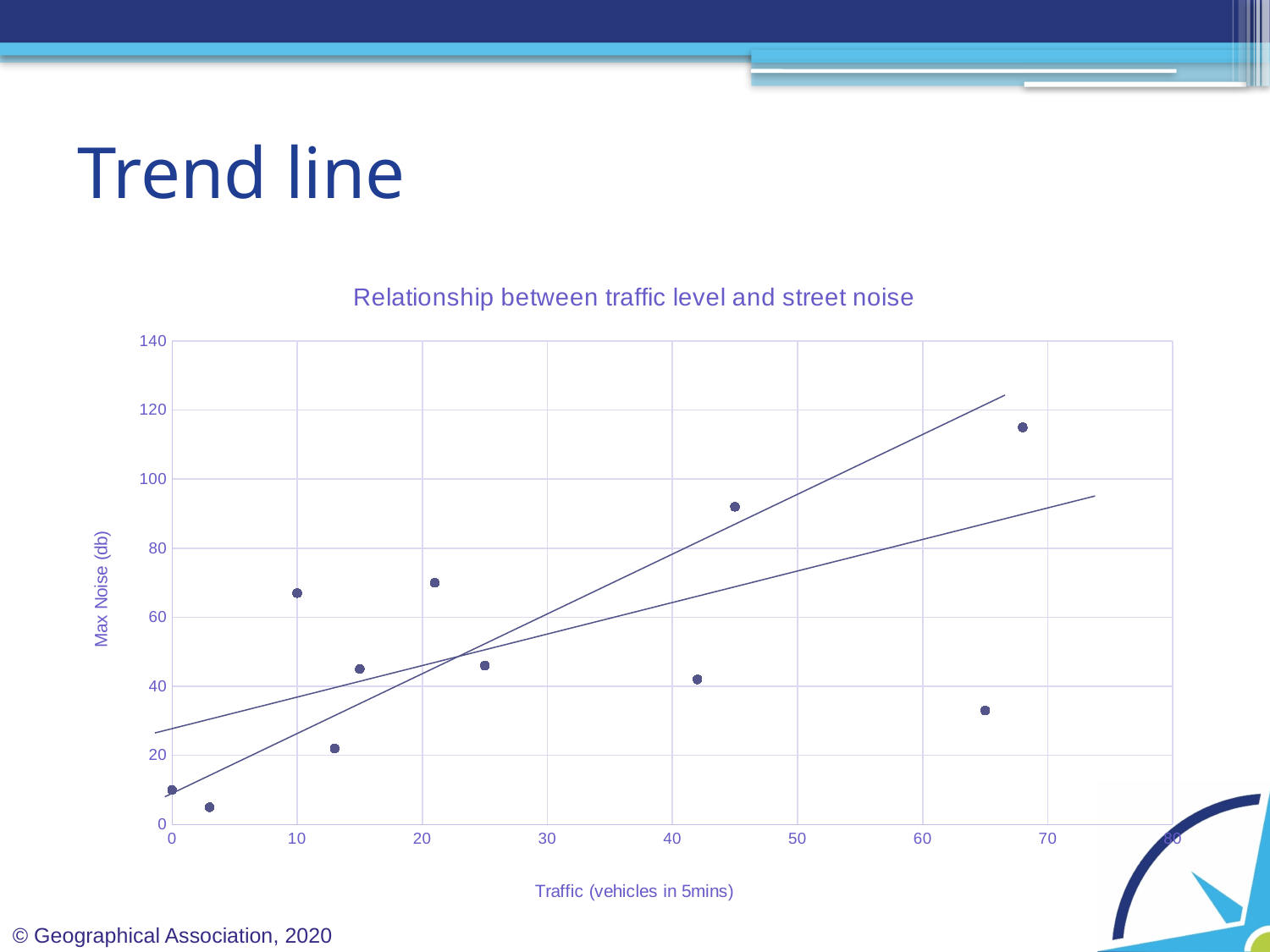
Is the Max Noise value for the point at about 13 vehicles greater or less than 40? less Is the Max Noise value for the point at about 65 vehicles greater or less than 40? less What is the title of the chart? Relationship between traffic level and street noise Do the trend lines show noise rising or falling as traffic increases? rising Is the Max Noise value for the point at about 21 vehicles greater or less than 60? greater How many data points are plotted on the chart? 11 What is the label of the vertical axis? Max Noise (db) Which point has the higher Max Noise: the one at about 10 vehicles or the one at about 42 vehicles? the one at about 10 vehicles What kind of chart is shown on the slide? scatter chart